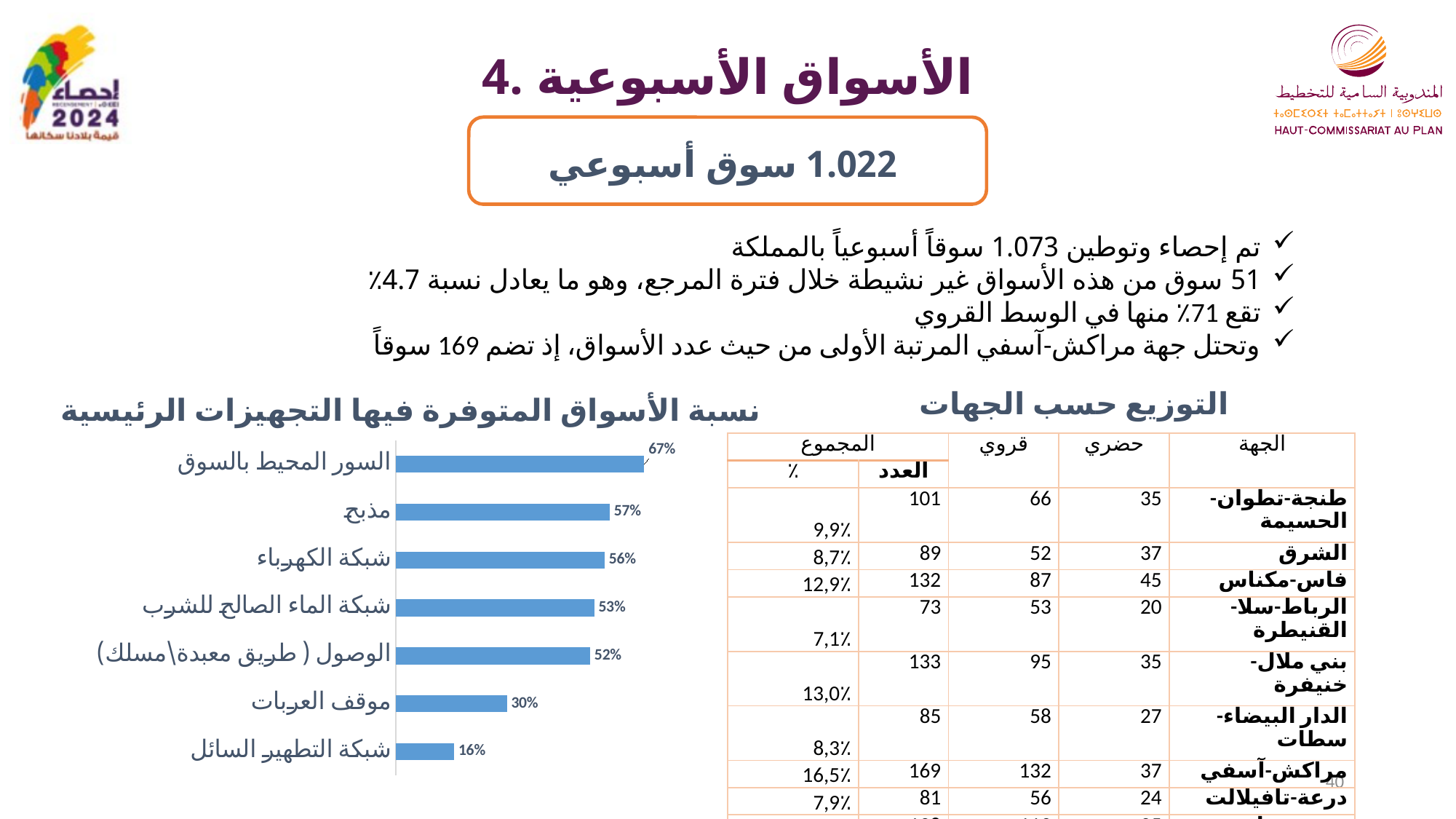
What is the value for السور المحيط بالسوق in the bar chart? 67% What type of chart is shown on the slide? bar chart Which category has the lowest value in the bar chart? شبكة التطهير السائل Which is larger: the value for الوصول ( طريق معبدة\مسلك) or the value for موقف العربات? الوصول ( طريق معبدة\مسلك) What is the value for موقف العربات in the bar chart? 30% What is the difference between the values for السور المحيط بالسوق and شبكة التطهير السائل? 51% What is the title of the bar chart? نسبة الأسواق المتوفرة فيها التجهيزات الرئيسية Which category has the highest value in the bar chart? السور المحيط بالسوق What is the value for شبكة الماء الصالح للشرب in the bar chart? 53% How many categories does the bar chart show? 7 What is the value for مذبح in the bar chart? 57% What is the value for شبكة الكهرباء in the bar chart? 56%